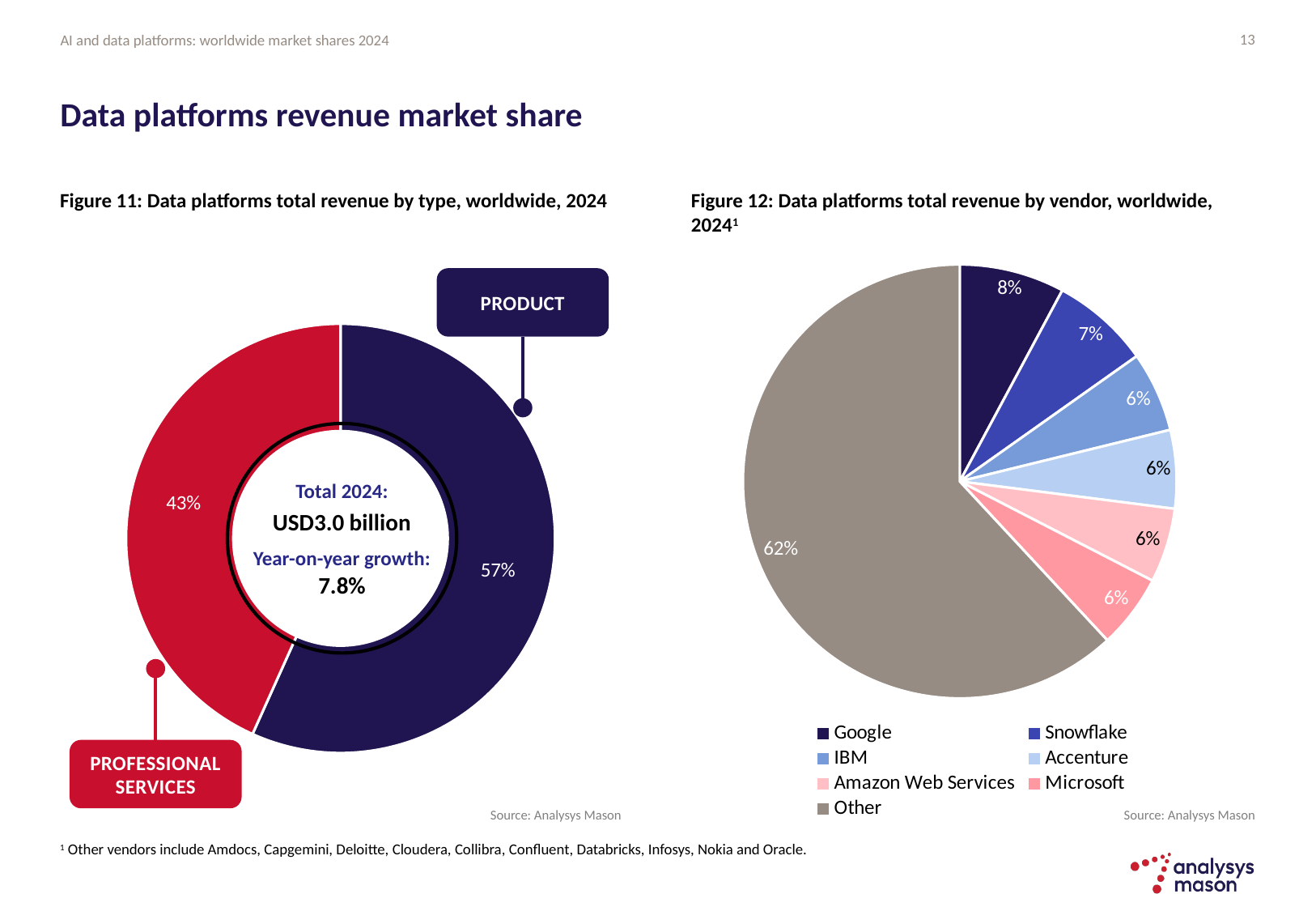
In Figure 11, what share of data platforms total revenue comes from Product? 57% In Figure 11, which revenue type has the larger share, Product or Professional Services? Product In Figure 11, what is the total 2024 data platforms revenue shown in the centre of the chart? USD3.0 billion What kind of chart is Figure 12? Pie chart In Figure 12, what share of data platforms revenue does Snowflake hold? 7% In Figure 12, how many vendor categories does the legend list? 7 In Figure 12, what is the difference in percentage points between the Other share and the Google share? 54 percentage points In Figure 12, which vendor category has the largest share of revenue? Other In Figure 11, what year-on-year growth rate is shown in the centre of the chart? 7.8% In Figure 11, what share of data platforms total revenue comes from Professional Services? 43% In Figure 12, what share of data platforms revenue does Google hold? 8% In Figure 11, what is the difference in percentage points between the Product and Professional Services shares? 14 percentage points